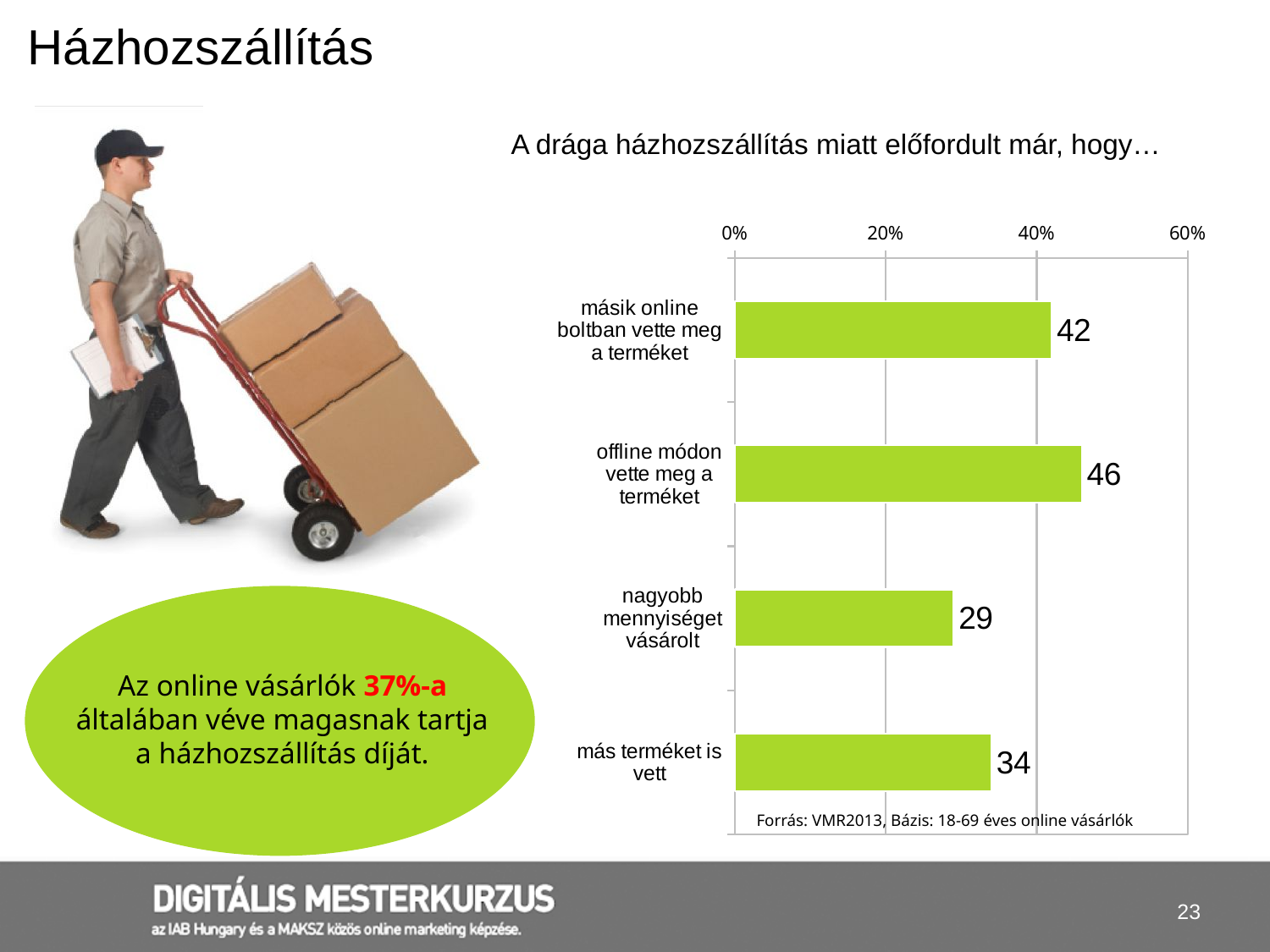
How many categories are shown in the chart? 4 What is the difference between the values for "offline módon vette meg a terméket" and "másik online boltban vette meg a terméket"? 4 What is the title of the chart? A drága házhozszállítás miatt előfordult már, hogy… What is the value for "más terméket is vett"? 34 Which category has the highest value? offline módon vette meg a terméket Which category has the lowest value? nagyobb mennyiséget vásárolt What is the value for "másik online boltban vette meg a terméket"? 42 Which is larger: the value for "más terméket is vett" or "nagyobb mennyiséget vásárolt"? más terméket is vett What is the value for "nagyobb mennyiséget vásárolt"? 29 What is the value for "offline módon vette meg a terméket"? 46 Is the value for "másik online boltban vette meg a terméket" greater or less than 40%? greater What kind of chart is shown on the slide? bar chart